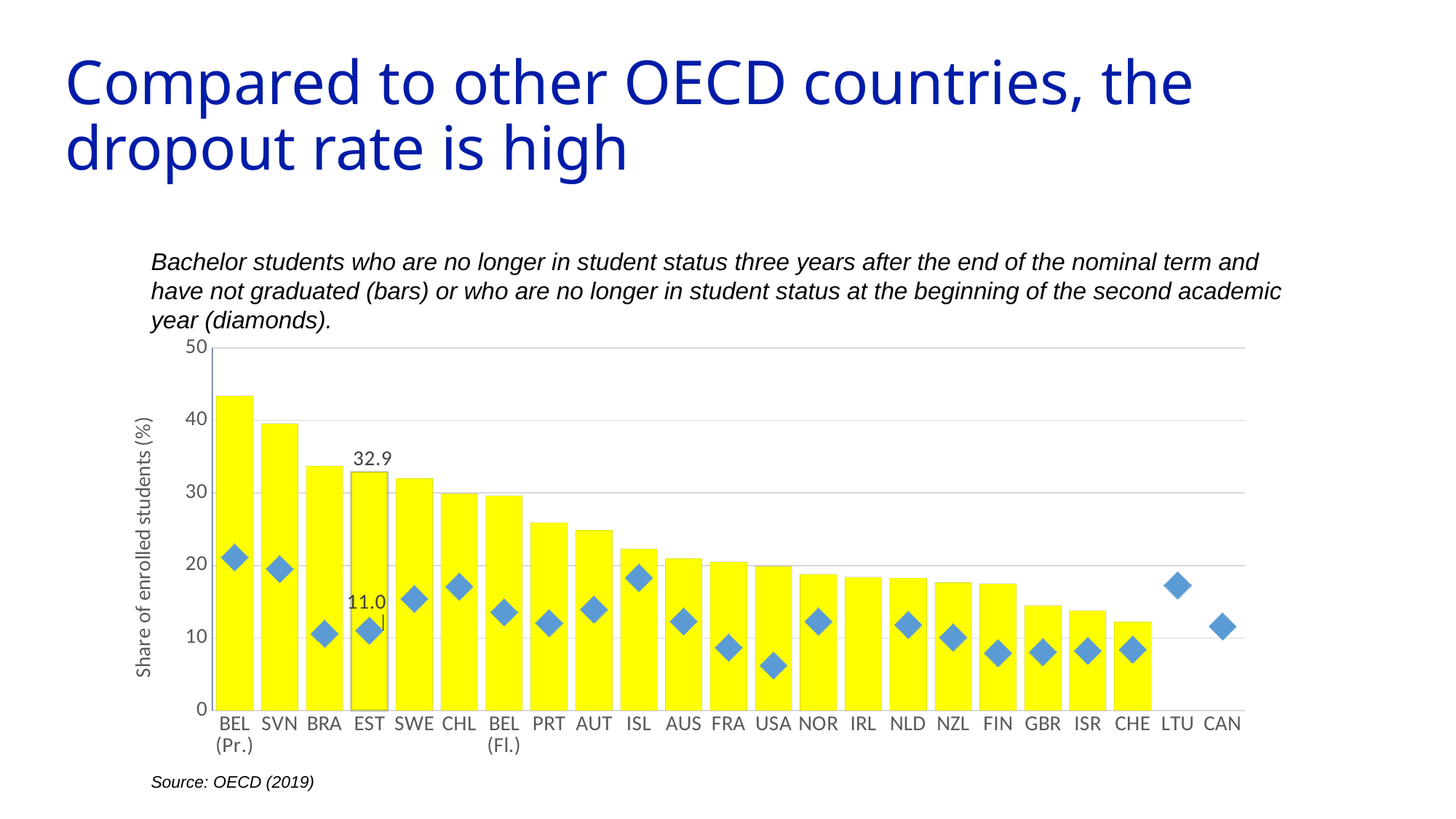
Is the bar for CHE greater or less than 10? greater What is the value of the diamond marker for EST? 11.0 How many countries are listed on the x axis? 23 Which country has the highest bar? BEL (Pr.) Which country has the lowest diamond marker? USA What is the value of the bar for EST? 32.9 What is the label of the y axis? Share of enrolled students (%) What is the difference between the bar value and the diamond value for EST? 21.9 Which has the larger bar, BEL (Pr.) or SVN? BEL (Pr.) Do the bar values rise or fall from left to right along the x axis? fall Is the diamond marker for LTU greater or less than 20? less Is the bar for BEL (Pr.) greater or less than 40? greater